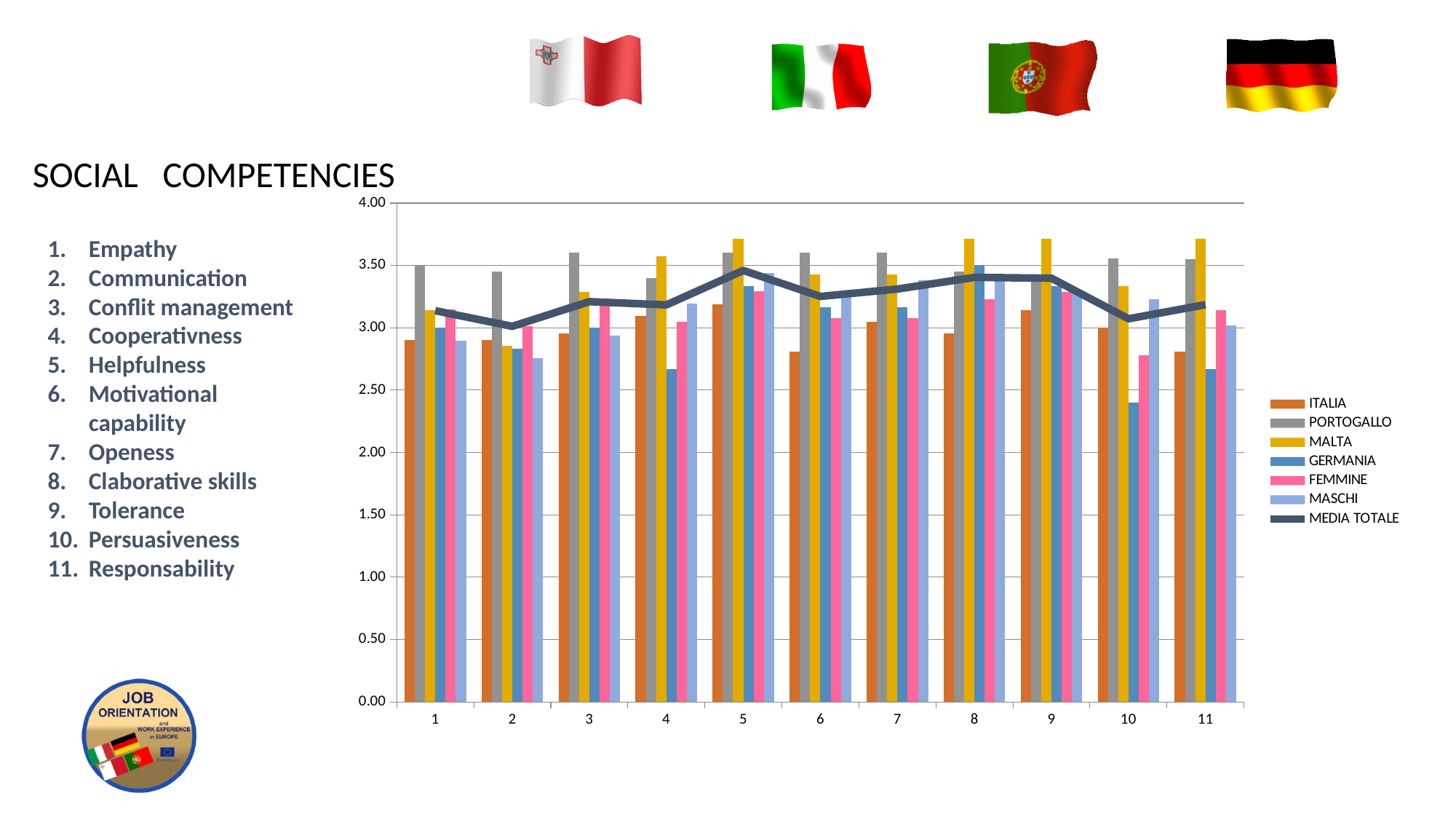
How many categories are shown along the x axis of the chart? 11 At category 10, which is larger: the value for GERMANIA or the value for MASCHI? MASCHI Is the value for GERMANIA at category 10 greater or less than 2.50? less Which series is drawn as a line rather than bars in the chart? MEDIA TOTALE How many series does the chart legend list? 7 Is the value for PORTOGALLO at category 3 greater or less than 3.50? greater Is the value for GERMANIA at category 4 greater or less than 3.00? less What kind of chart is shown on the slide? Bar chart with a line series At category 1, which is larger: the value for PORTOGALLO or the value for ITALIA? PORTOGALLO For the GERMANIA series, which category has the lowest value? 10